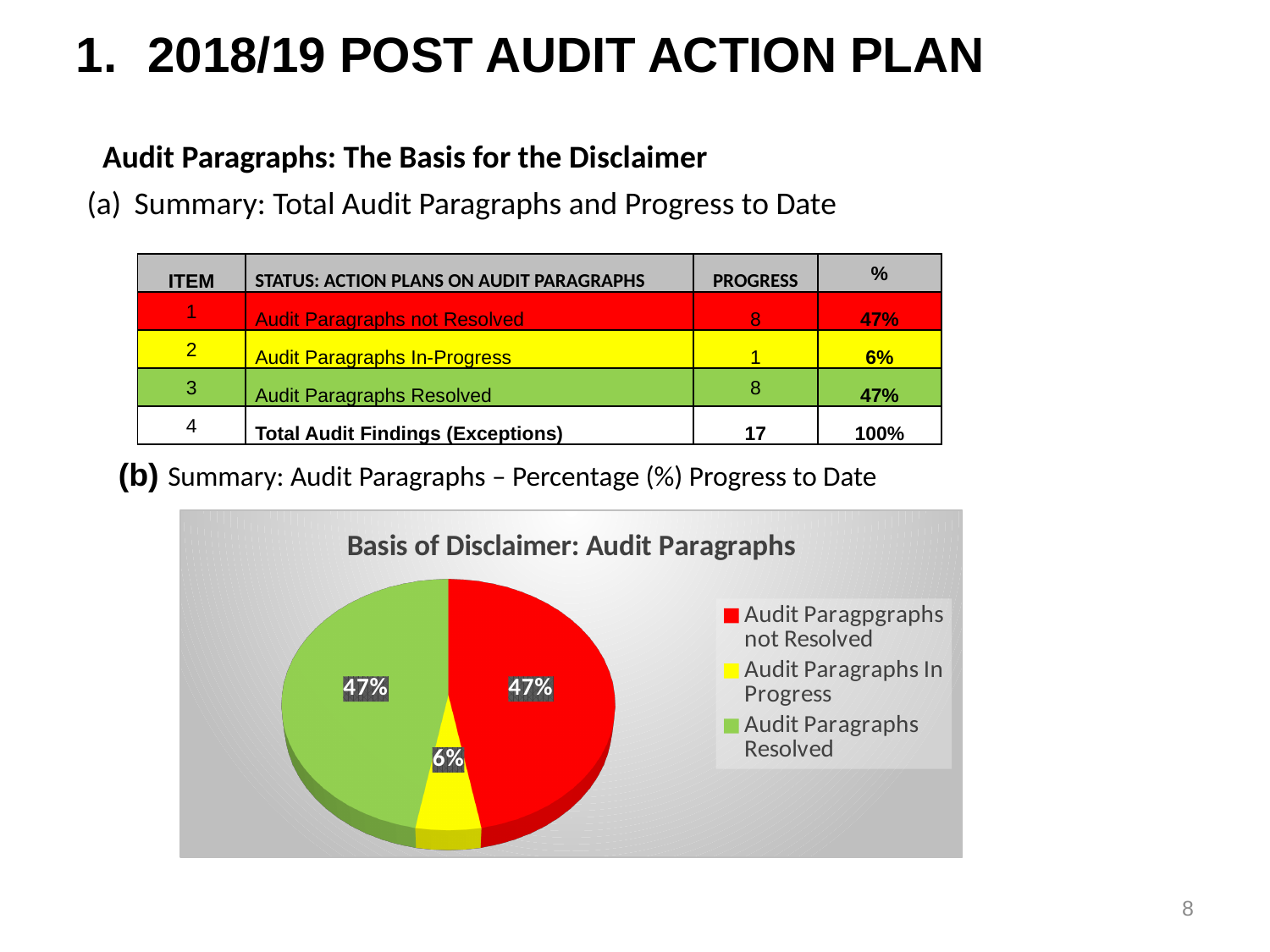
How many slices does the pie chart have? 3 What type of chart is shown on the slide? Pie chart What is the difference in percentage points between the Audit Paragraphs not Resolved slice and the Audit Paragraphs In Progress slice? 41% Which is larger: the slice for Audit Paragraphs Resolved or the slice for Audit Paragraphs In Progress? Audit Paragraphs Resolved What percentage of the pie is labelled for Audit Paragraphs In Progress? 6% What percentage of the pie is labelled for Audit Paragraphs Resolved? 47% What colour is the slice for Audit Paragraphs Resolved? Green What share of the pie do the Audit Paragraphs not Resolved and Audit Paragraphs Resolved slices make up together? 94% What is the title of the chart? Basis of Disclaimer: Audit Paragraphs What percentage of the pie is labelled for Audit Paragraphs not Resolved? 47% How many entries does the chart legend list? 3 Which category has the smallest slice of the pie? Audit Paragraphs In Progress